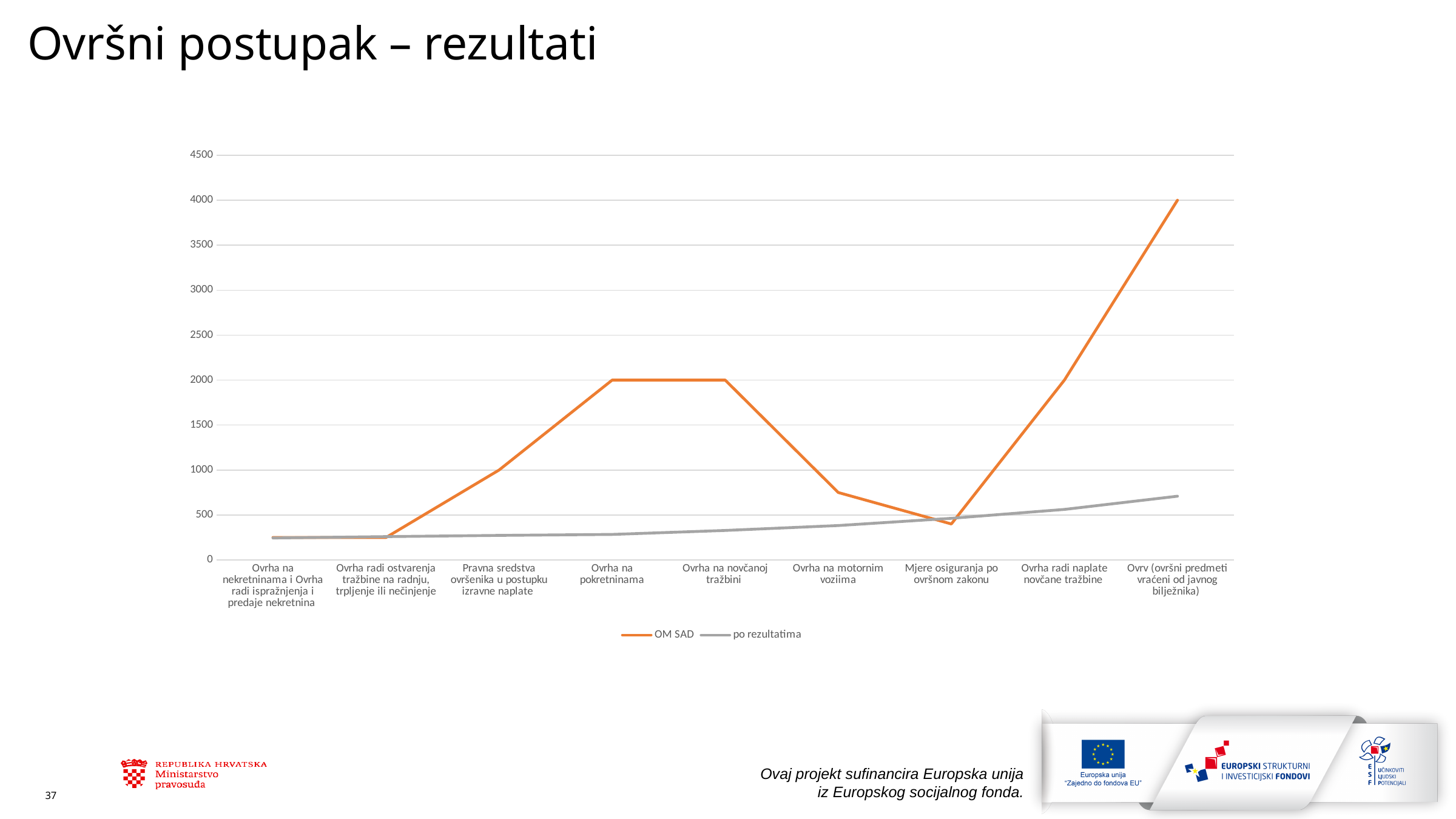
Does the po rezultatima series generally rise or fall along the x axis? rise For which category is the OM SAD series highest? Ovrv (ovršni predmeti vraćeni od javnog bilježnika) How many series does the legend list? 2 What kind of chart is shown on the slide? line chart For which category is the po rezultatima series highest? Ovrv (ovršni predmeti vraćeni od javnog bilježnika) Which series is drawn in orange? OM SAD At Ovrha na pokretninama, which series has the larger value, OM SAD or po rezultatima? OM SAD Is the po rezultatima value for Ovrv (ovršni predmeti vraćeni od javnog bilježnika) greater or less than 500? greater What is the value of the OM SAD series for Ovrv (ovršni predmeti vraćeni od javnog bilježnika)? 4000 Is the OM SAD value for Ovrha na motornim voziima greater or less than 1000? less What is the value of the OM SAD series for Ovrha na pokretninama? 2000 How many categories are shown on the x axis? 9